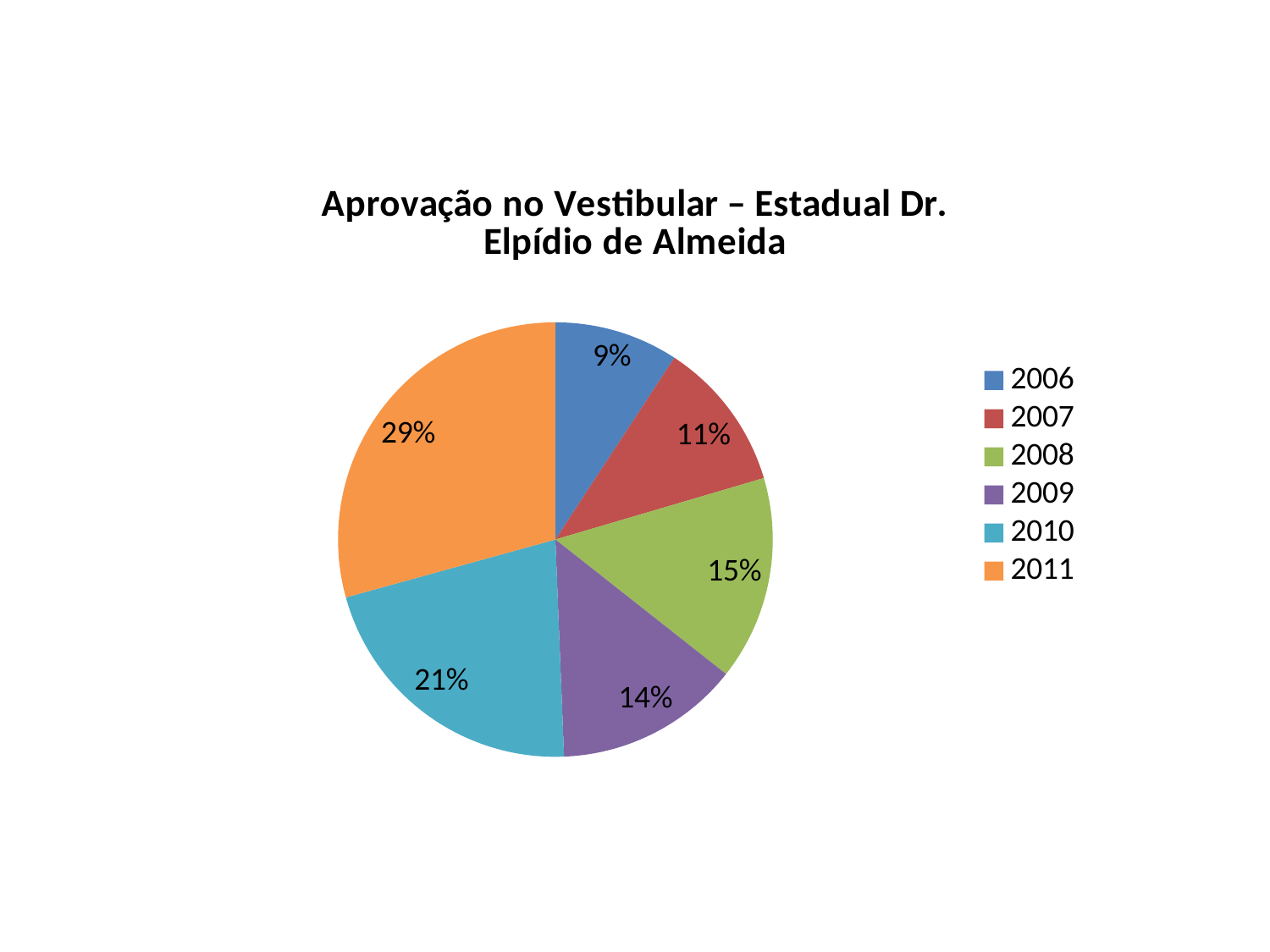
Which year has the smallest slice of the pie? 2006 What is the value shown for 2008? 15% What share of the pie does 2011 represent? 29% What is the value shown for 2006? 9% What is the difference in percentage points between 2011 and 2010? 8 How many slices does the pie chart have? 6 Which is larger, the slice for 2009 or the slice for 2010? 2010 What kind of chart is shown on the slide? Pie chart Which year has the largest slice of the pie? 2011 What is the value shown for 2010? 21% What is the title of the chart? Aprovação no Vestibular – Estadual Dr. Elpídio de Almeida What is the difference in percentage points between 2008 and 2007? 4